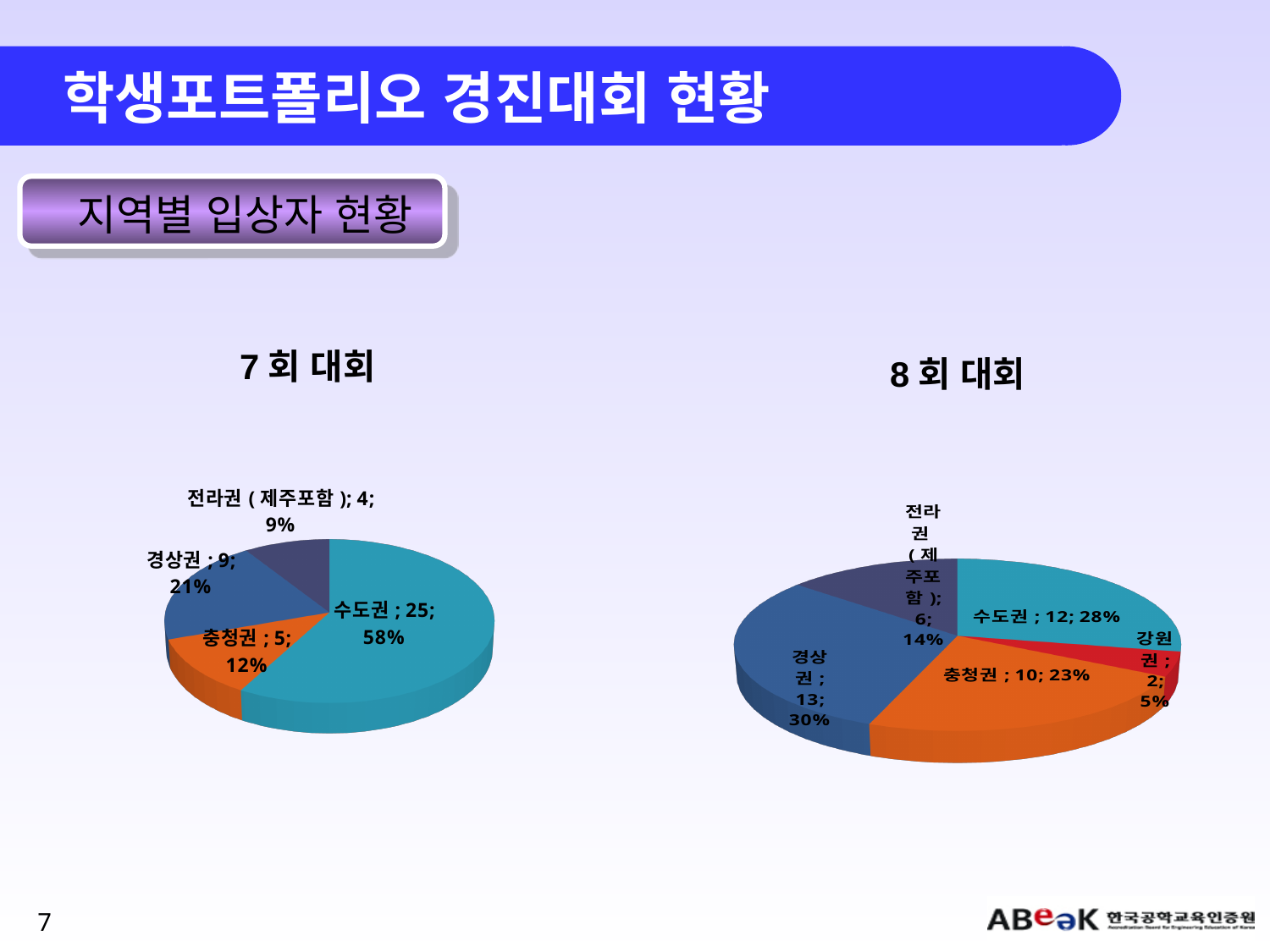
In the 7 회 대회 chart, how many slices does the pie have? 4 What type of chart is used for the 7 회 대회 data? Pie chart In the 7 회 대회 chart, what value is shown for 수도권? 25 In the 8 회 대회 chart, which is larger, the value for 수도권 or the value for 충청권? 수도권 In the 7 회 대회 chart, what is the difference between the values for 수도권 and 충청권? 20 In the 8 회 대회 chart, how many slices does the pie have? 5 In the 7 회 대회 chart, which region has the smallest slice? 전라권 (제주포함) In the 8 회 대회 chart, what value is shown for 경상권? 13 In the 8 회 대회 chart, which region has the smallest slice? 강원권 In the 8 회 대회 chart, what share of the pie does 충청권 have? 23% In the 7 회 대회 chart, what share of the pie does 경상권 have? 21% In the 8 회 대회 chart, which region has the largest slice? 경상권